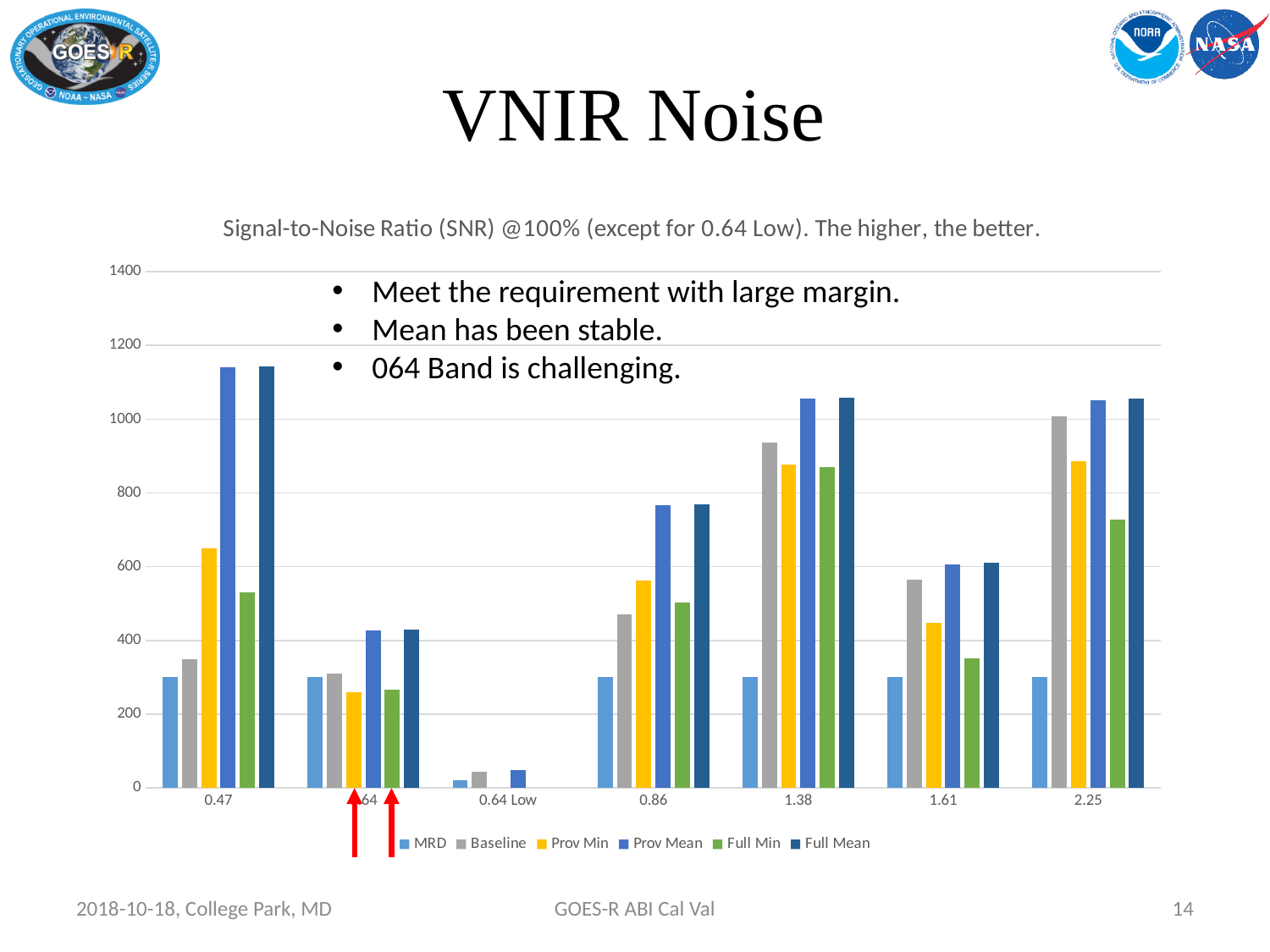
Is the MRD value for 0.86 greater or less than 400? less Is the Full Min value for 2.25 greater or less than 800? less What kind of chart is shown on the slide? bar chart Is the Prov Mean value for 0.47 greater or less than 1000? greater How many categories are shown along the x axis of the chart? 7 Which category has the highest Full Mean value? 0.47 What is the title of the chart? Signal-to-Noise Ratio (SNR) @100% (except for 0.64 Low). The higher, the better. Which series is listed last in the chart legend? Full Mean How many series does the chart legend list? 6 Which category has the lowest values overall in the chart? 0.64 Low